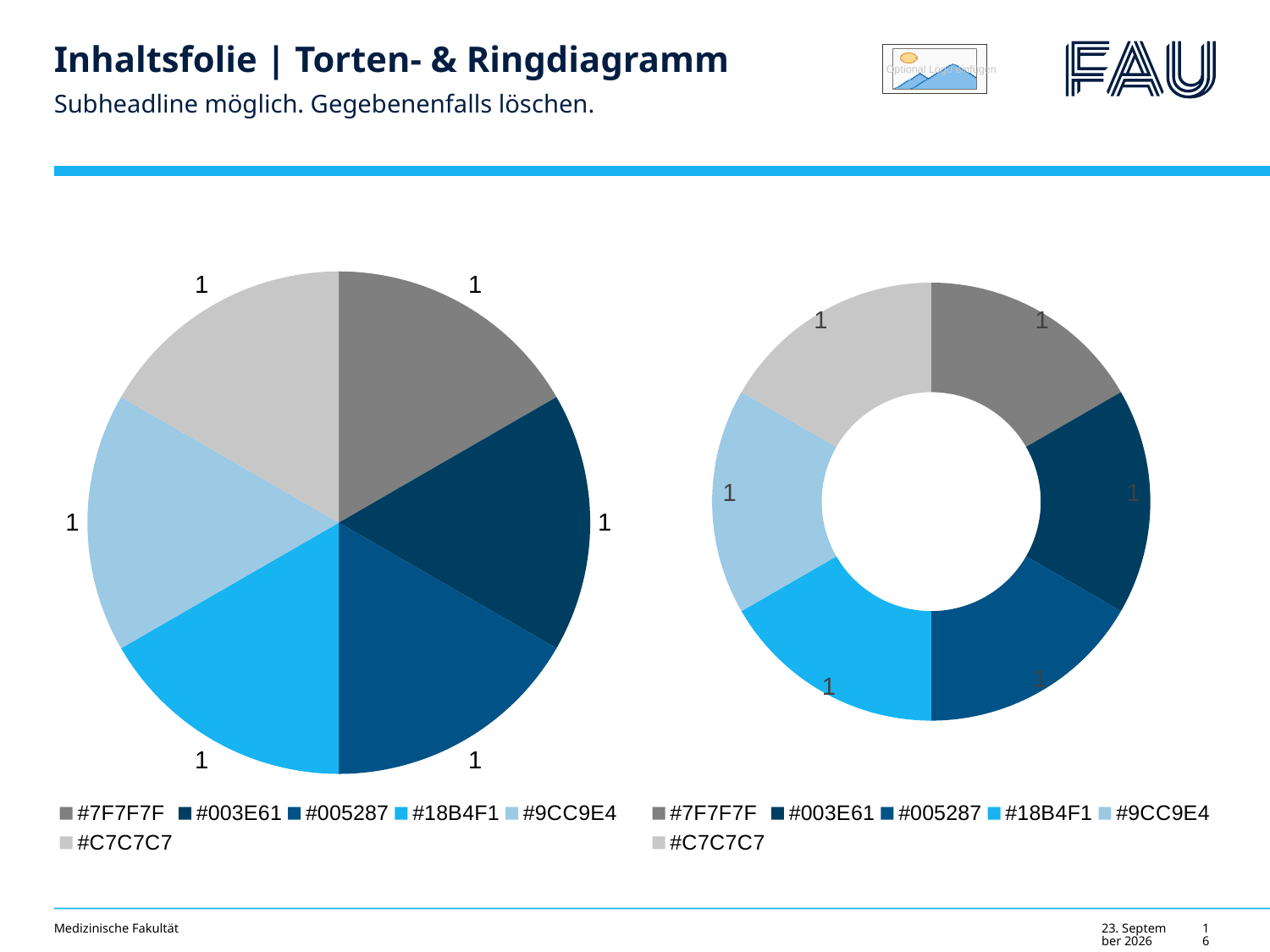
In the pie chart on the left, is the value for #003E61 larger than, smaller than, or equal to the value for #C7C7C7? equal In the pie chart on the left, what is the total of all slice values? 6 In the pie chart on the left, which legend entry is listed first? #7F7F7F What kind of chart is the chart on the right of the slide? doughnut chart In the doughnut chart on the right, how many segments are there? 6 In the pie chart on the left, what fraction of the whole does the #9CC9E4 slice represent? 1/6 What kind of chart is the chart on the left of the slide? pie chart How many entries does the legend of the doughnut chart on the right list? 6 In the pie chart on the left, what is the value of the #7F7F7F slice? 1 In the doughnut chart on the right, what is the total of all segment values? 6 In the doughnut chart on the right, what is the value of the #18B4F1 segment? 1 In the pie chart on the left, how many slices are there? 6